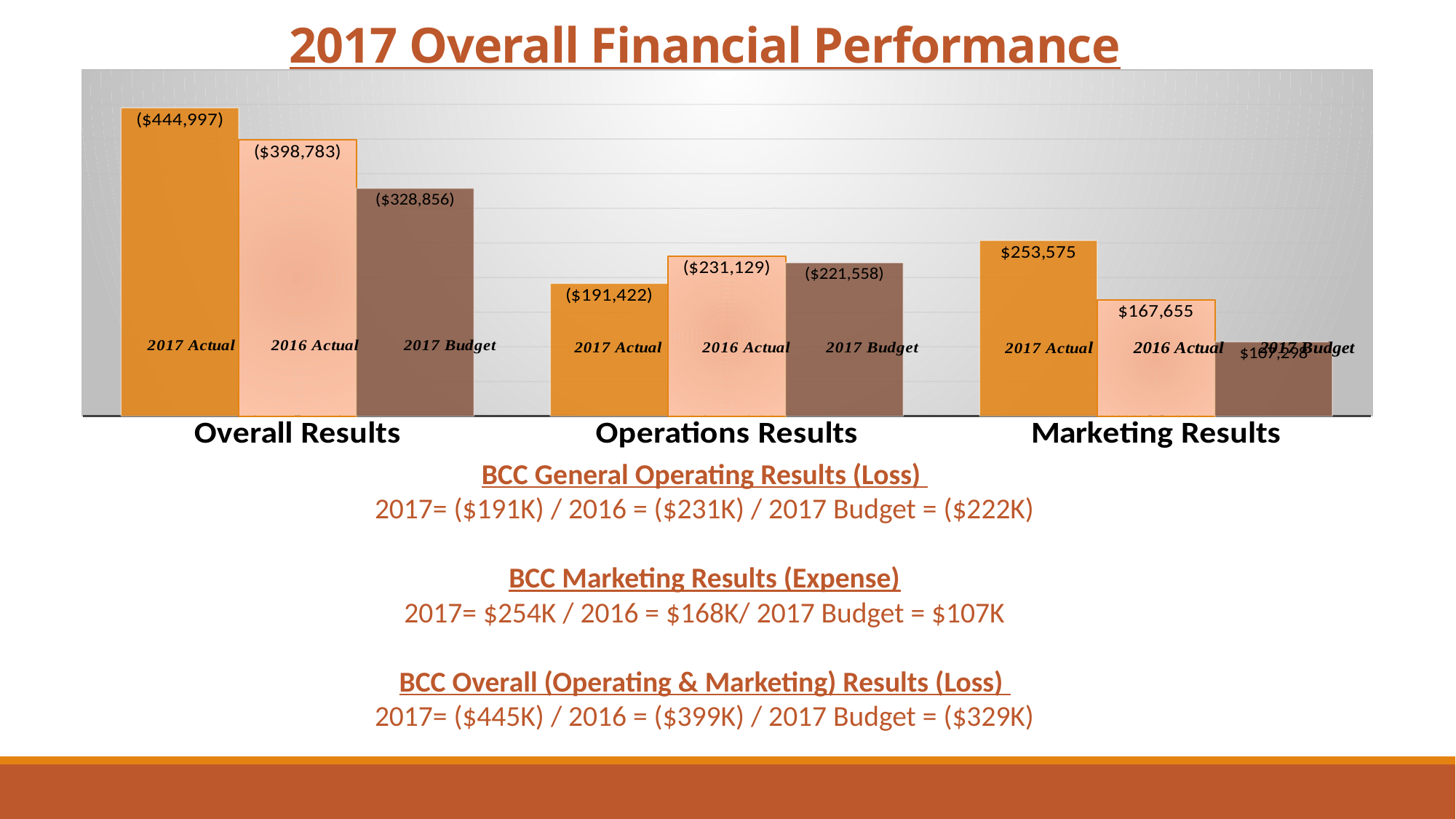
What is the difference between the 2017 Actual and 2016 Actual values for Overall Results? $46,214 What is the 2016 Actual value for Operations Results? ($231,129) What is the 2017 Budget value for Operations Results? ($221,558) How many categories are shown on the x axis of the chart? 3 What is the 2017 Budget value for Overall Results? ($328,856) What is the 2017 Actual value for Marketing Results? $253,575 Which category has the tallest 2017 Actual bar? Overall Results Within Operations Results, which bar is taller: 2017 Actual or 2016 Actual? 2016 Actual What is the 2017 Actual value for Overall Results? ($444,997) What is the 2016 Actual value for Marketing Results? $167,655 What kind of chart is shown on the slide? Bar chart Within Marketing Results, which bar is the shortest? 2017 Budget